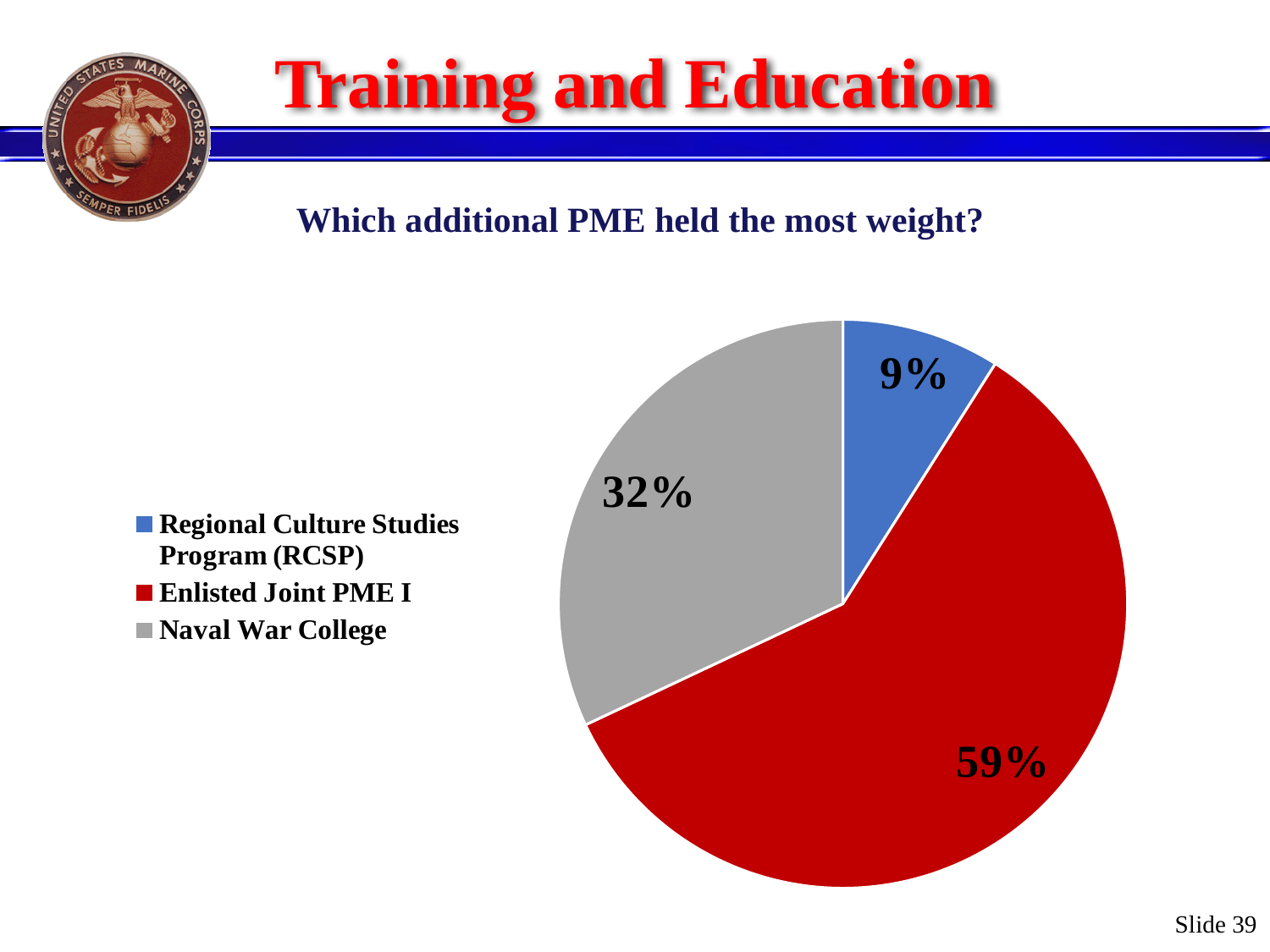
What share of the pie does Regional Culture Studies Program (RCSP) hold? 9% What kind of chart is shown on the slide? pie chart What is the difference in percentage points between Naval War College and Regional Culture Studies Program (RCSP)? 23 What colour is the slice for Enlisted Joint PME I? red What share of the pie does Naval War College hold? 32% Which is larger, the slice for Naval War College or the slice for Regional Culture Studies Program (RCSP)? Naval War College Which category has the smallest slice of the pie? Regional Culture Studies Program (RCSP) Which category has the largest slice of the pie? Enlisted Joint PME I What share of the pie does Enlisted Joint PME I hold? 59% What is the difference in percentage points between Enlisted Joint PME I and Naval War College? 27 What question is posed above the pie chart? Which additional PME held the most weight? How many categories does the pie chart show? 3